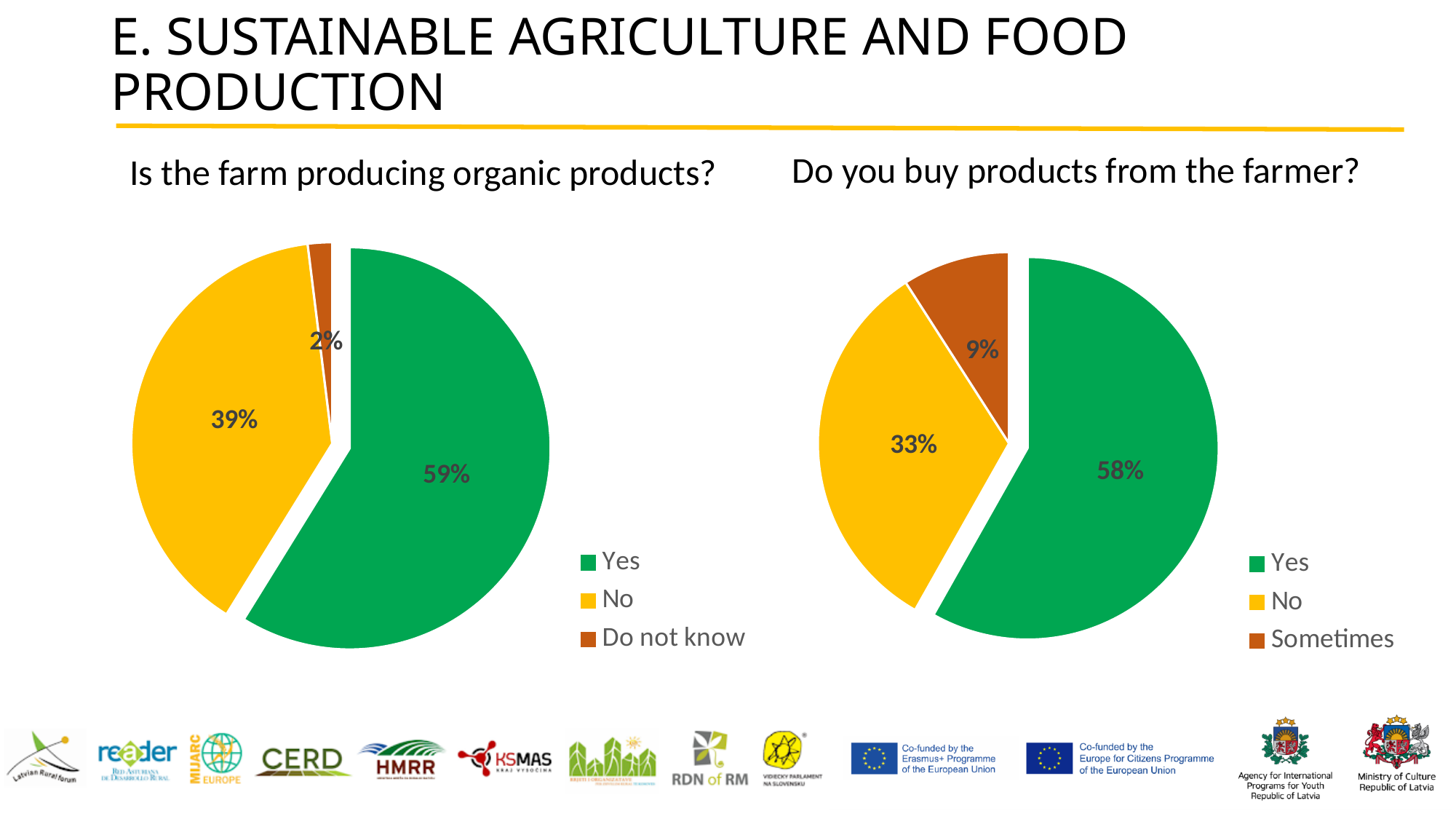
In the 'Is the farm producing organic products?' chart, what share of responses is 'No'? 39% In the 'Is the farm producing organic products?' chart, what share of responses is 'Yes'? 59% In the 'Is the farm producing organic products?' chart, which category has the largest slice? Yes In the 'Do you buy products from the farmer?' chart, which category has the smallest slice? Sometimes In the 'Do you buy products from the farmer?' chart, which is larger, 'No' or 'Sometimes'? No In the 'Is the farm producing organic products?' chart, what share of responses is 'Do not know'? 2% In the 'Do you buy products from the farmer?' chart, what share of responses is 'Yes'? 58% How many categories does the legend of the 'Do you buy products from the farmer?' chart list? 3 In the 'Do you buy products from the farmer?' chart, what is the difference between the 'No' and 'Sometimes' shares? 24% In the 'Do you buy products from the farmer?' chart, what share of responses is 'Sometimes'? 9% What type of chart is used for 'Is the farm producing organic products?'? Pie chart In the 'Is the farm producing organic products?' chart, what is the difference between the 'Yes' and 'No' shares? 20%